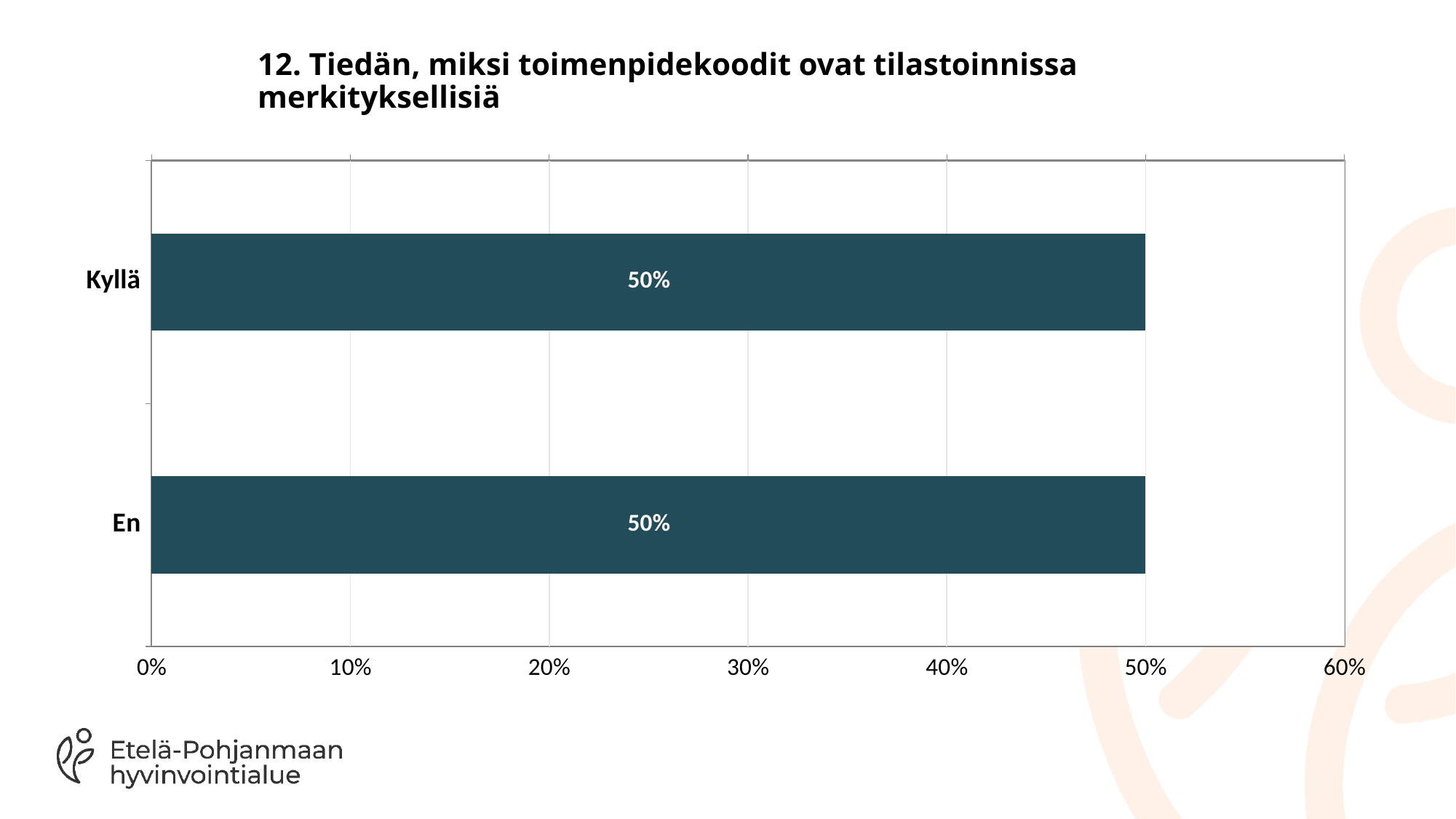
What kind of chart is shown on the slide? bar chart What is the highest value shown on the x axis? 60% Is the value for En greater or less than 60%? less How many categories are shown in the chart? 2 Is the value for Kyllä greater or less than 40%? greater What is the difference between the values for Kyllä and En? 0% What is the total of the values for Kyllä and En? 100% What is the value for Kyllä? 50% What is the title of the chart? 12. Tiedän, miksi toimenpidekoodit ovat tilastoinnissa merkityksellisiä What is the value for En? 50%